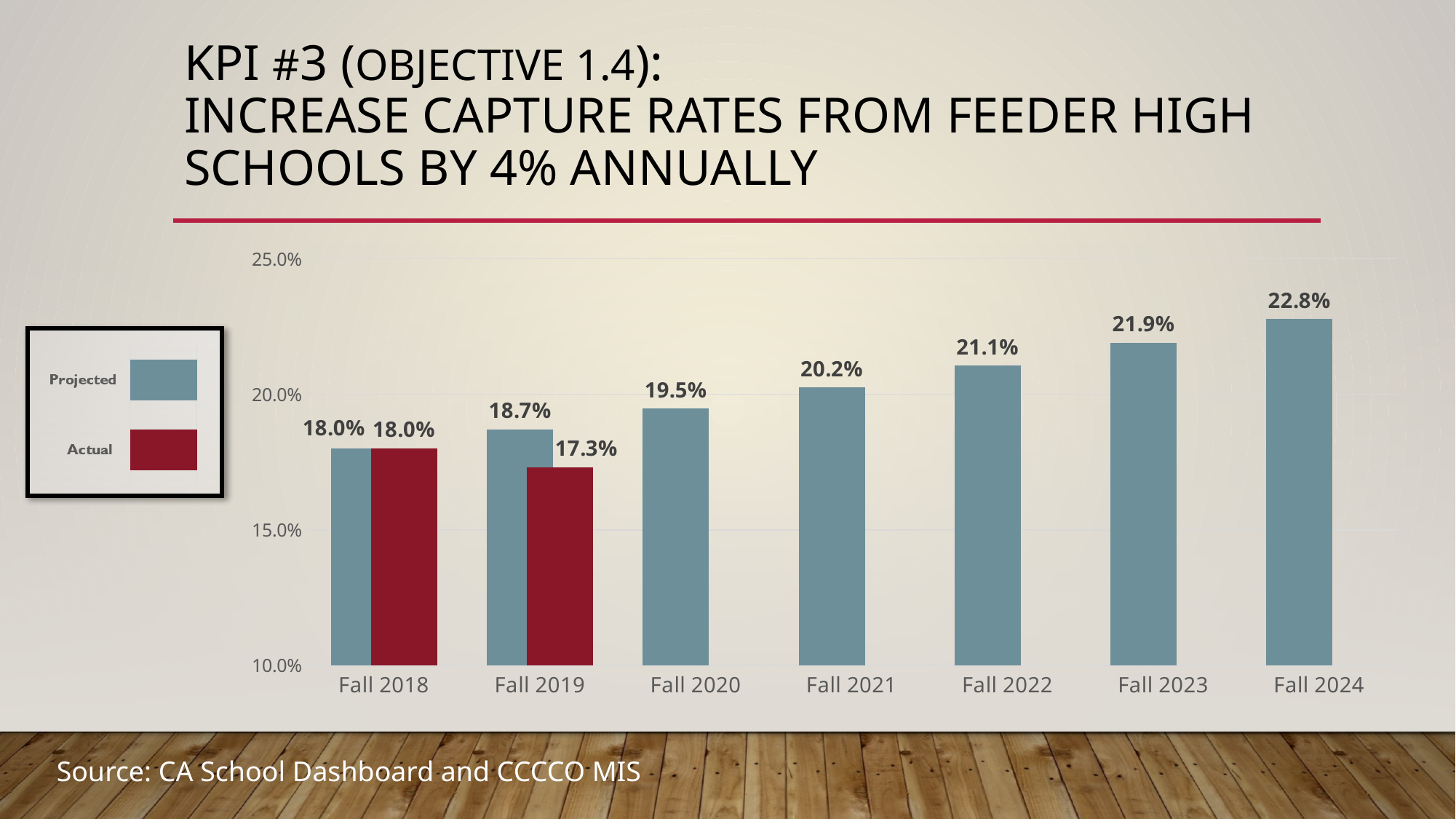
Do the Projected values rise or fall from Fall 2018 to Fall 2024? rise How many categories are shown on the x axis? 7 What is the Projected value for Fall 2020? 19.5% What is the Projected value for Fall 2024? 22.8% How many series does the legend list? 2 Is the Projected value for Fall 2021 greater or less than 20.0%? greater Which category has the lowest Projected value? Fall 2018 Which category has the highest Projected value? Fall 2024 Which is larger, the Projected value for Fall 2022 or the Projected value for Fall 2023? Fall 2023 What is the difference between the Projected and Actual values for Fall 2019? 1.4% What kind of chart is shown on the slide? bar chart What is the Actual value for Fall 2019? 17.3%